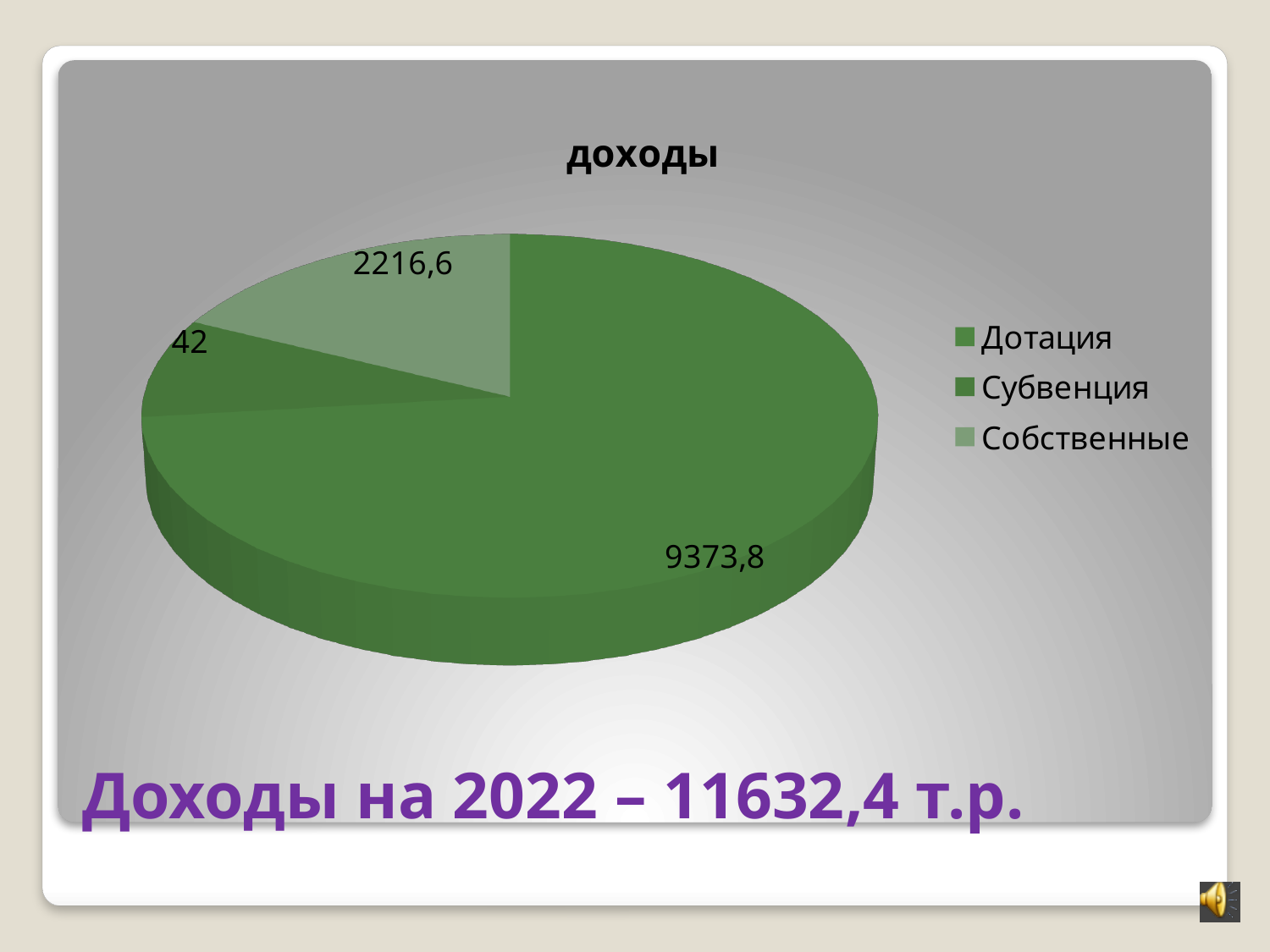
How many slices does the pie chart have? 3 What is the title of the chart? доходы What is the total of all three slices of the pie chart? 11632,4 What is the difference between the values for Дотация and Собственные? 7157,2 How many categories does the legend list? 3 What is the value for Дотация? 9373,8 What type of chart is shown on the slide? pie chart Which is larger, Собственные or Субвенция? Собственные Which category has the largest slice? Дотация Which category has the smallest slice? Субвенция What is the value for Субвенция? 42 What is the value for Собственные? 2216,6